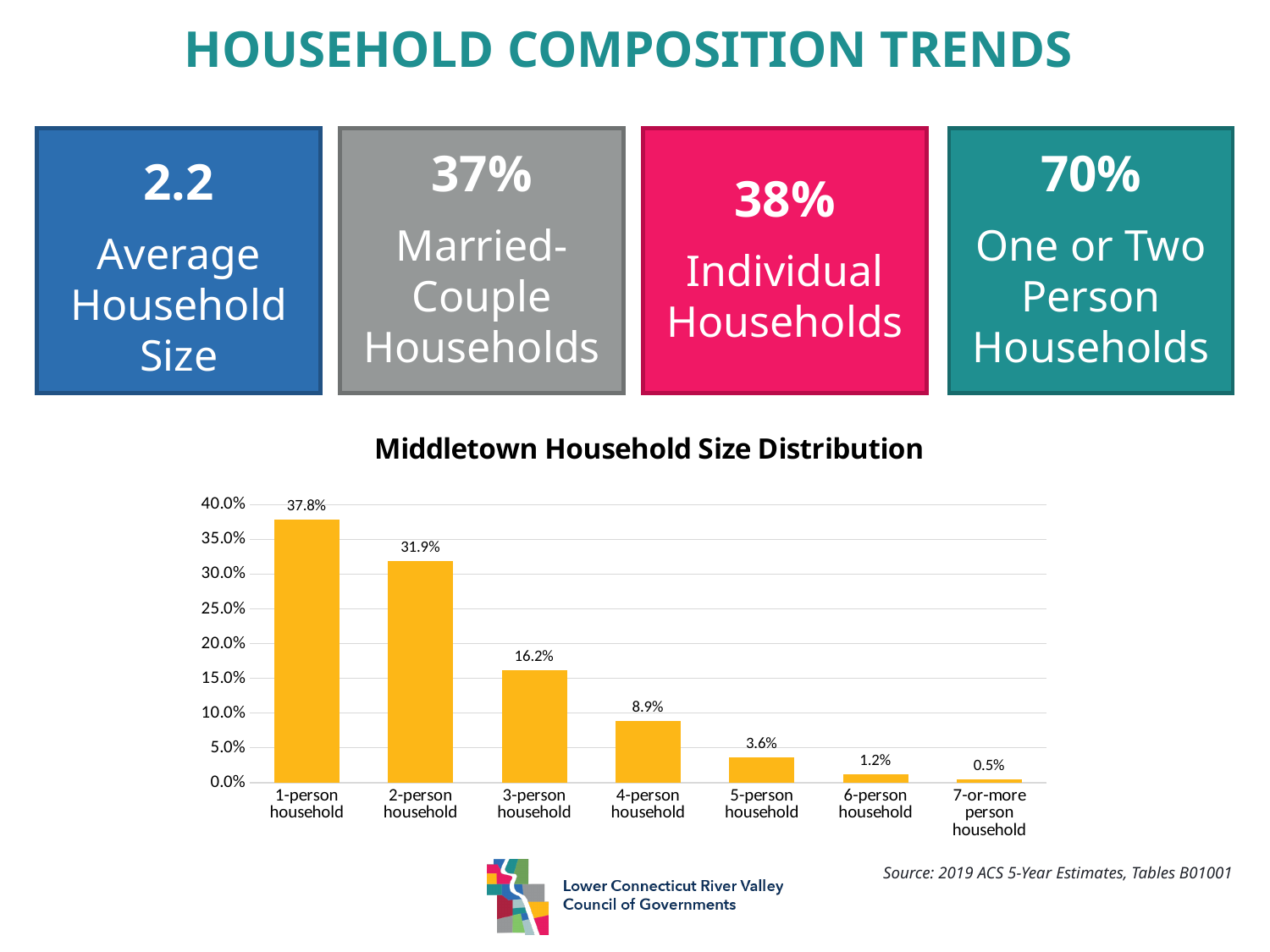
What is the title of the chart on the slide? Middletown Household Size Distribution Which household size category has the lowest value? 7-or-more person household What is the value for 3-person household? 16.2% Is the value for 2-person household greater or less than 30.0%? greater What kind of chart is the Middletown Household Size Distribution? bar chart Which household size category has the highest value? 1-person household What is the value for 1-person household in the Middletown Household Size Distribution chart? 37.8% How many household size categories are shown on the x axis? 7 What is the value for 7-or-more person household? 0.5% What is the difference between the values for 1-person household and 2-person household? 5.9% Do the values rise or fall as household size increases along the x axis? fall Which is larger, the value for 4-person household or 5-person household? 4-person household